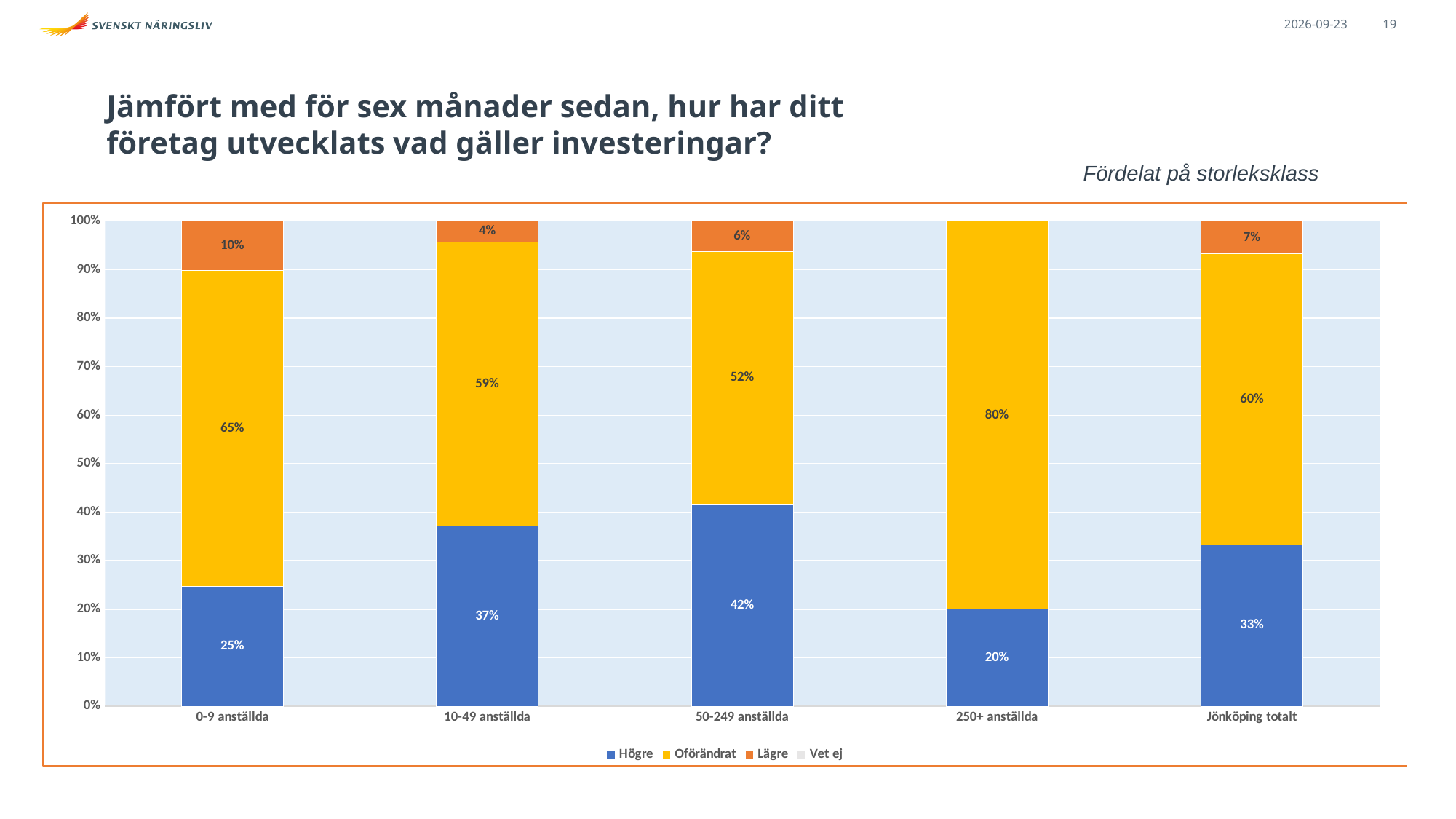
What is the subtitle shown above the chart on the right? Fördelat på storleksklass Which category has the lowest value for Högre? 250+ anställda How many series does the legend list? 4 What is the value for Oförändrat in the 250+ anställda category? 80% What is the value for Lägre in the 10-49 anställda category? 4% What kind of chart is shown on the slide? Stacked bar chart Which is larger, the Lägre value for 0-9 anställda or for 50-249 anställda? 0-9 anställda What is the value for Högre in the 0-9 anställda category? 25% Which category has the highest value for Högre? 50-249 anställda How many categories are shown on the x axis? 5 What is the difference between the Oförändrat values for 250+ anställda and 0-9 anställda? 15% What is the value for Lägre in the Jönköping totalt category? 7%